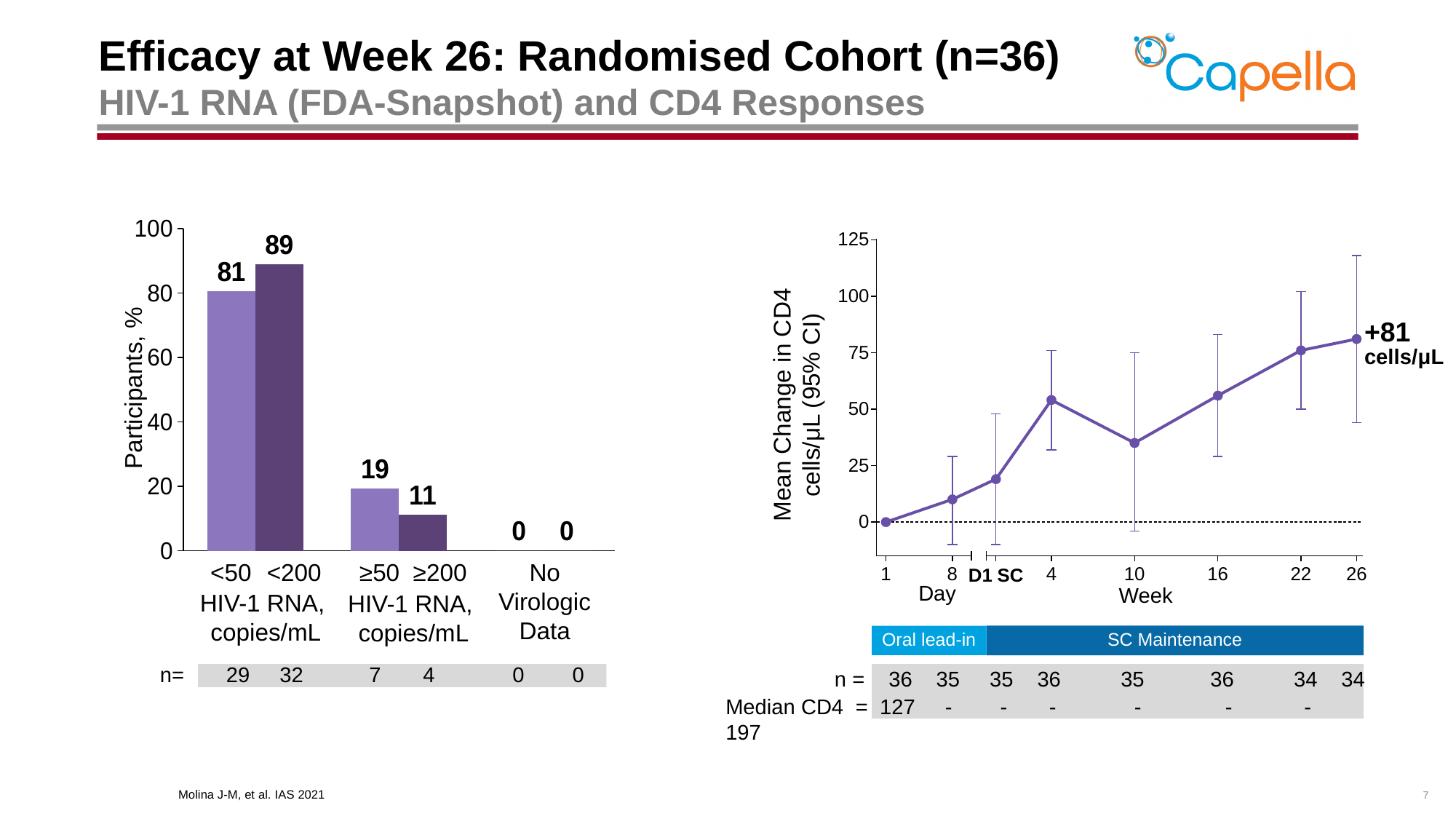
In the right chart, what is the mean change in CD4 cells/µL at Week 26? +81 cells/µL In the right chart, is the mean change in CD4 at Week 22 greater or less than 50? greater In the left bar chart, what percentage of participants had HIV-1 RNA ≥200 copies/mL? 11 In the left bar chart, what value is shown for the No Virologic Data bars? 0 What type of chart is the right chart? Line chart In the left bar chart, which is larger: the ≥50 bar or the ≥200 bar? ≥50 In the right chart, is the mean change in CD4 at Week 10 greater or less than 50? less In the left bar chart, what is the difference between the <200 and <50 HIV-1 RNA percentages? 8 In the left bar chart, what percentage of participants had HIV-1 RNA <50 copies/mL? 81 In the left bar chart, what percentage of participants had HIV-1 RNA <200 copies/mL? 89 What type of chart is the left chart? Bar chart In the left bar chart, which bar has the highest value? <200 HIV-1 RNA, copies/mL